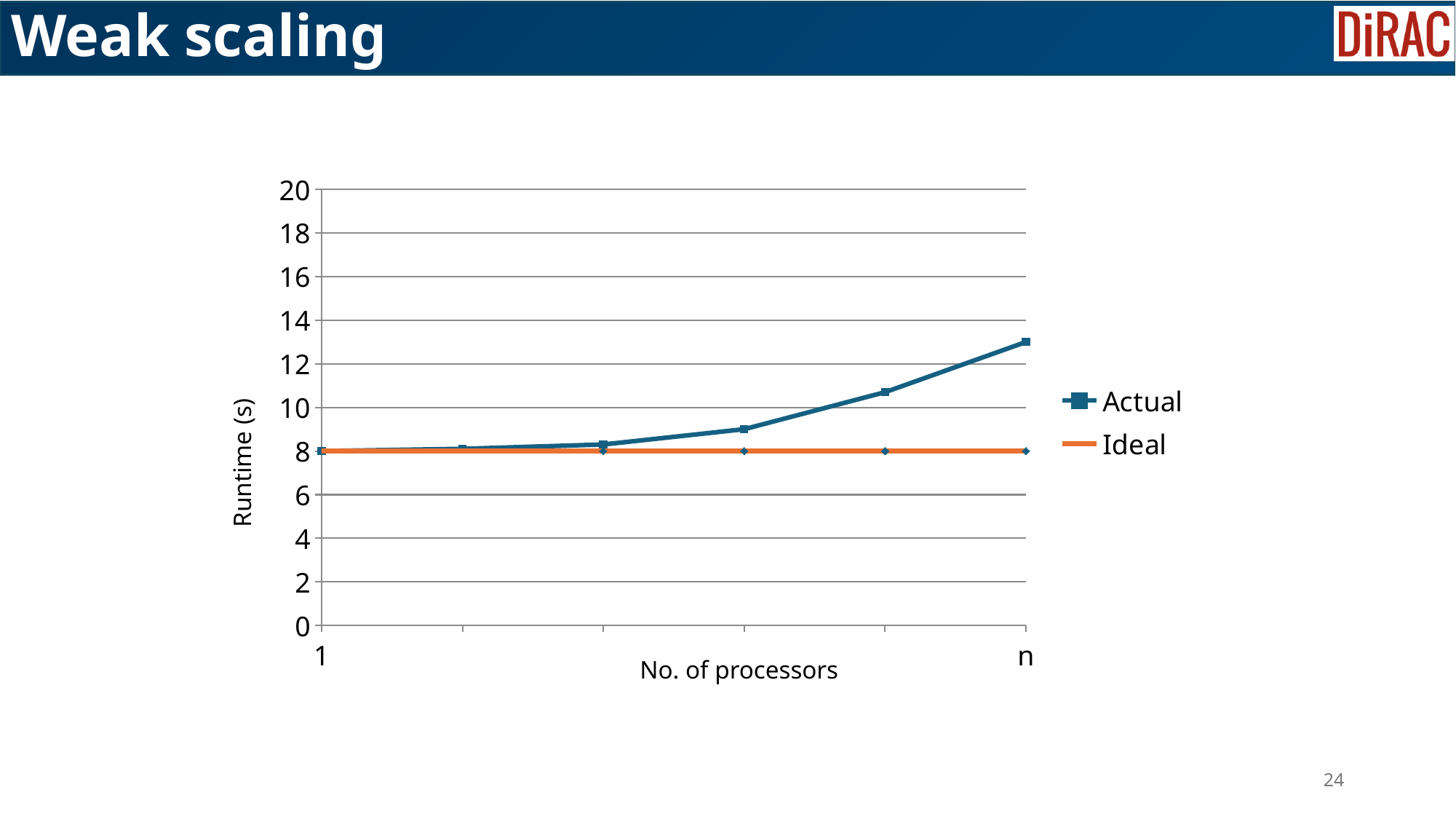
What is the runtime of the Actual series at 1 processor? 8 How many series does the legend list? 2 What is the runtime of the Ideal series at n processors? 8 At n processors, which series has the higher runtime, Actual or Ideal? Actual What is the runtime of the Ideal series at 1 processor? 8 What is the label of the y axis? Runtime (s) Is the Actual runtime at n processors greater or less than 14? less Does the Ideal runtime rise, fall or stay constant as the number of processors increases? stays constant Does the Actual runtime rise or fall as the number of processors increases? rises What are the two series named in the legend? Actual and Ideal Is the Actual runtime at n processors greater or less than 12? greater What type of chart is shown on the slide? line chart